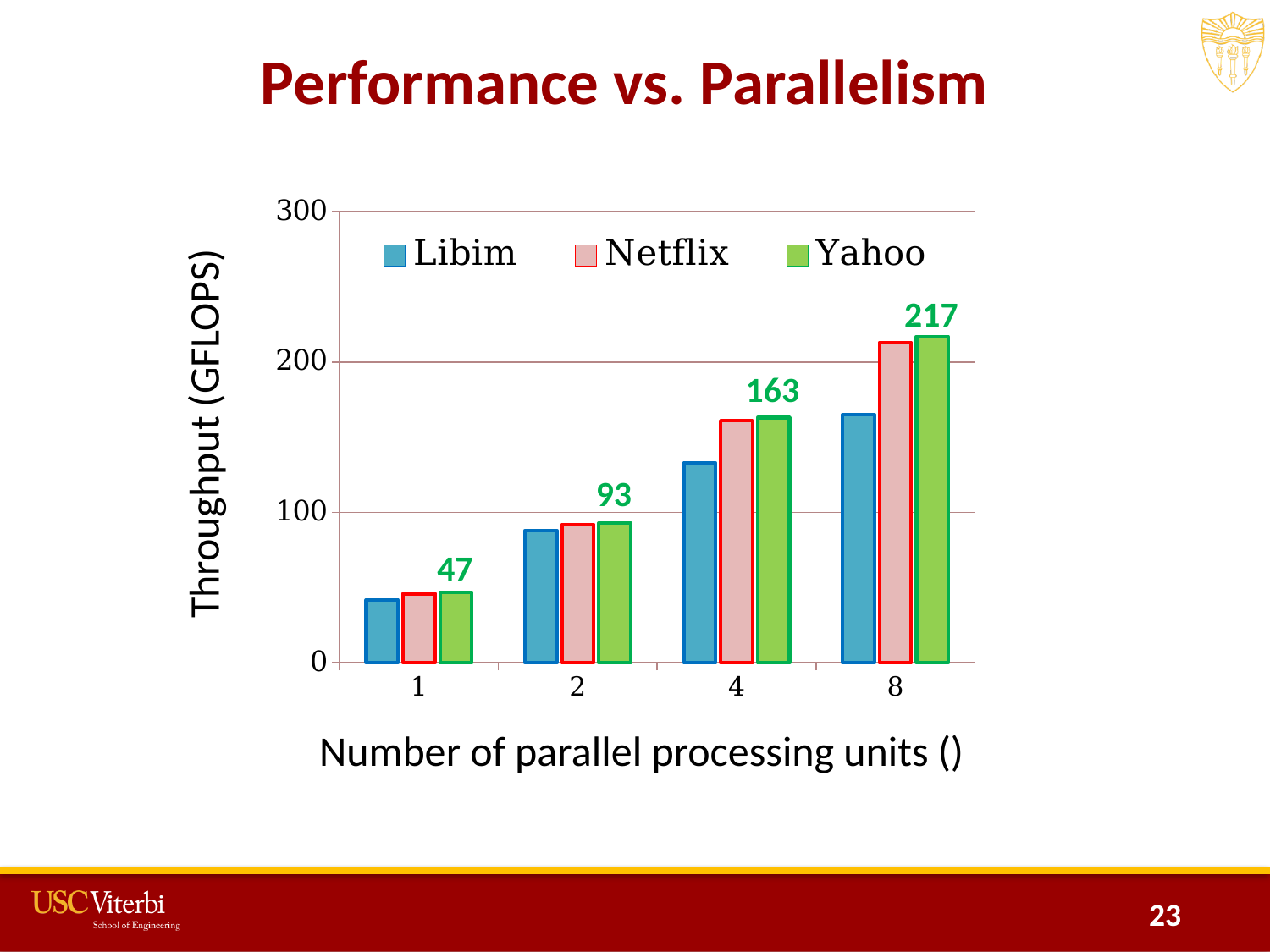
Does the throughput rise or fall as the number of parallel processing units increases? rise What is the Yahoo throughput at 8 parallel processing units? 217 At which number of parallel processing units is the Yahoo throughput lowest? 1 What kind of chart is shown on the slide? bar chart How many series does the legend list? 3 Is the Libim throughput at 8 parallel processing units greater or less than 200? less At which number of parallel processing units is the Yahoo throughput highest? 8 What is the difference between the Yahoo throughput at 8 units and at 4 units? 54 What is the Yahoo throughput at 4 parallel processing units? 163 What is the Yahoo throughput at 1 parallel processing unit? 47 Is the Libim throughput at 2 parallel processing units greater or less than 100? less At 8 parallel processing units, which has the higher throughput, Libim or Yahoo? Yahoo